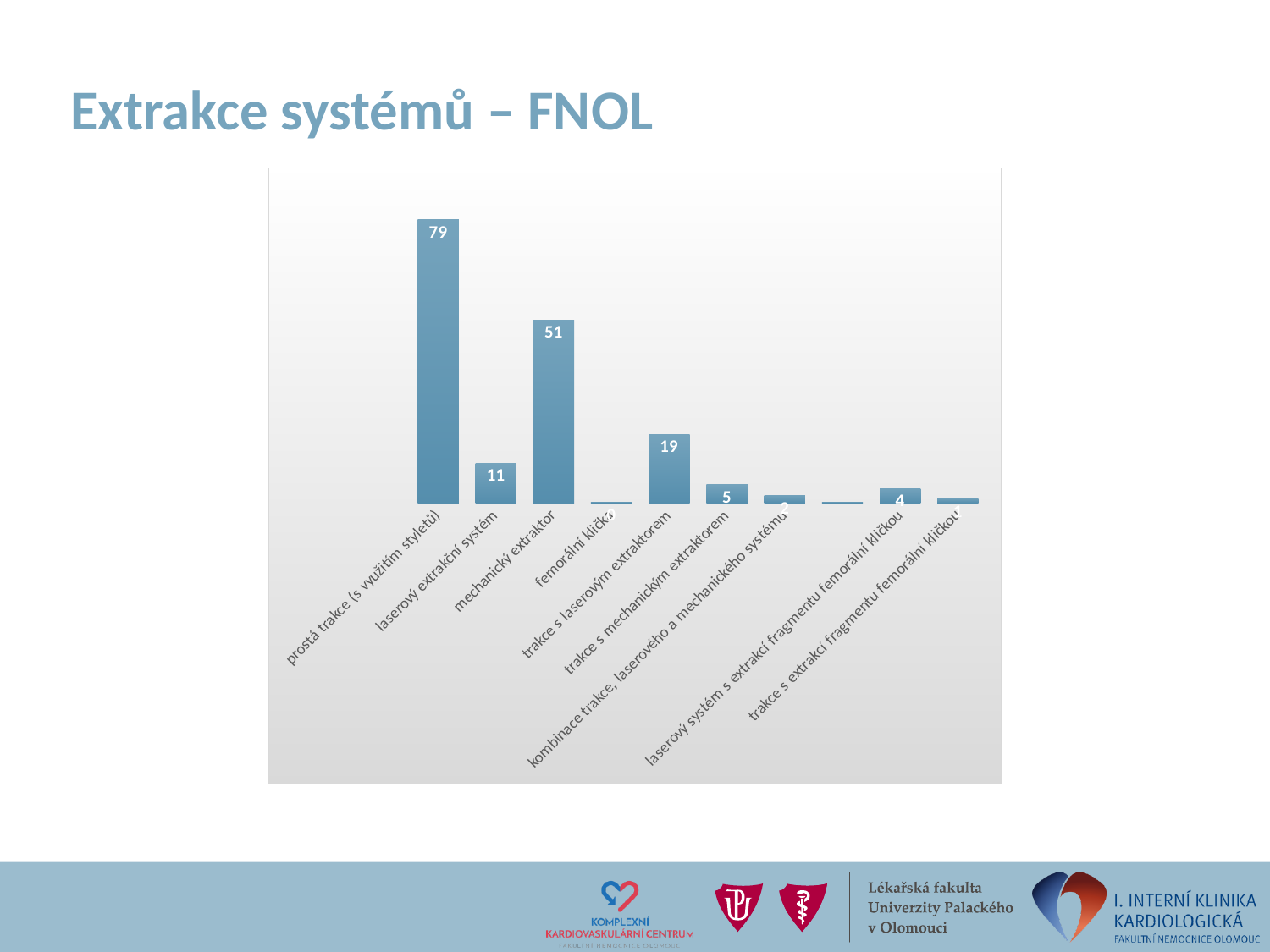
Which category has the highest value? prostá trakce (s využitím styletů) Which is larger, the value for 'laserový extrakční systém' or the value for 'trakce s laserovým extraktorem'? trakce s laserovým extraktorem What type of chart is shown on the slide? bar chart What is the title of the slide containing the chart? Extrakce systémů – FNOL What is the value for 'trakce s laserovým extraktorem'? 19 What is the value for 'laserový extrakční systém'? 11 What is the difference between the values for 'mechanický extraktor' and 'trakce s laserovým extraktorem'? 32 What is the value for 'prostá trakce (s využitím styletů)'? 79 What is the value for 'trakce s mechanickým extraktorem'? 5 Which is larger, the value for 'trakce s mechanickým extraktorem' or the value for 'laserový extrakční systém'? laserový extrakční systém What is the value for 'mechanický extraktor'? 51 What is the difference between the values for 'prostá trakce (s využitím styletů)' and 'mechanický extraktor'? 28